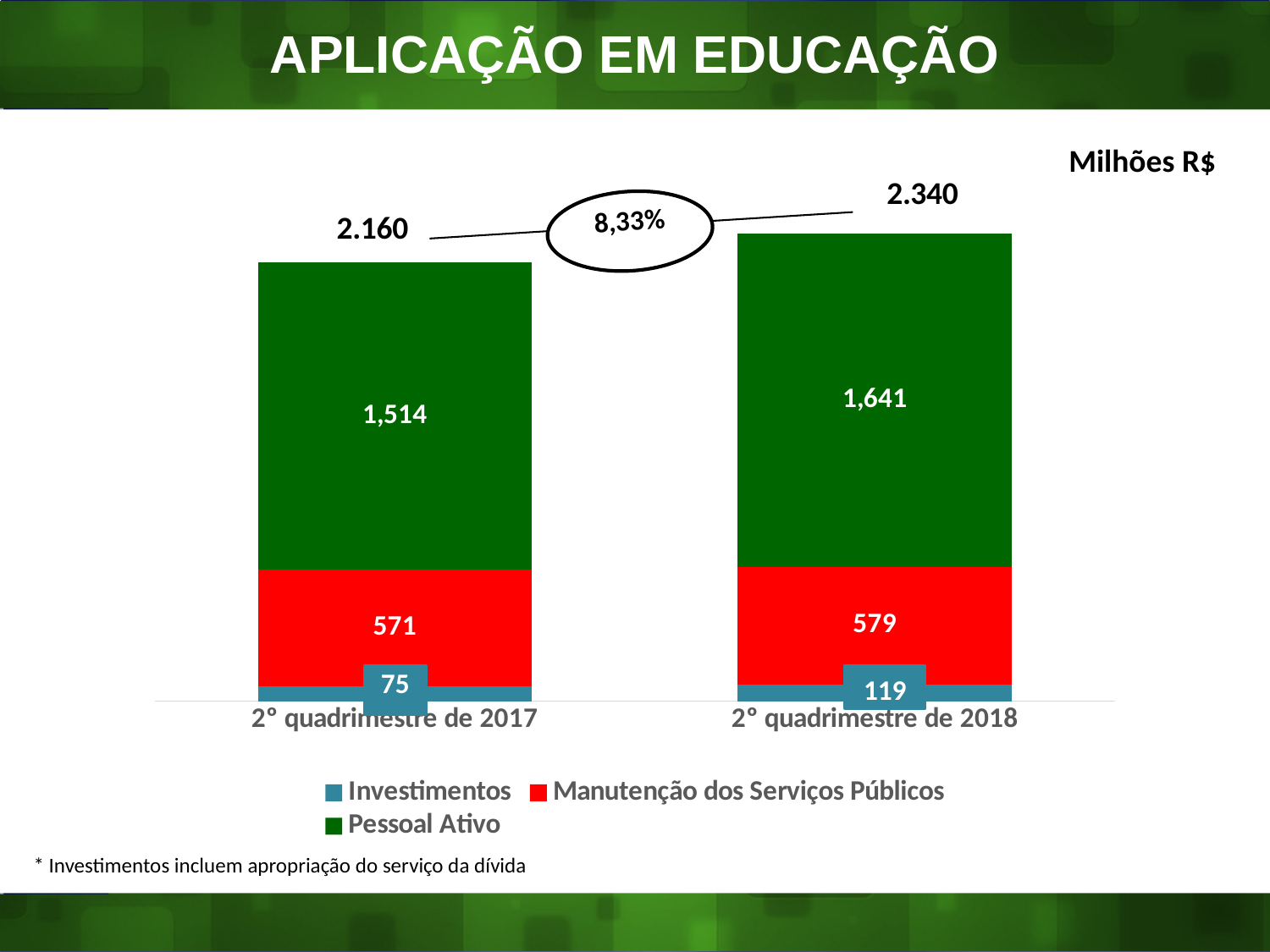
What percentage change is shown in the oval between the two bars? 8,33% How many series does the legend list? 3 Which series has the smallest value in 2° quadrimestre de 2017? Investimentos Which is larger, Manutenção dos Serviços Públicos in 2° quadrimestre de 2017 or in 2° quadrimestre de 2018? 2° quadrimestre de 2018 What is the value of Manutenção dos Serviços Públicos for 2° quadrimestre de 2017? 571 What is the total shown above the bar for 2° quadrimestre de 2018? 2.340 What kind of chart is shown on the slide? Stacked bar chart What is the value of Pessoal Ativo for 2° quadrimestre de 2018? 1,641 What is the difference between the Investimentos values for 2° quadrimestre de 2018 and 2° quadrimestre de 2017? 44 What is the value of Investimentos for 2° quadrimestre de 2018? 119 What is the value of Pessoal Ativo for 2° quadrimestre de 2017? 1,514 What is the total shown above the bar for 2° quadrimestre de 2017? 2.160